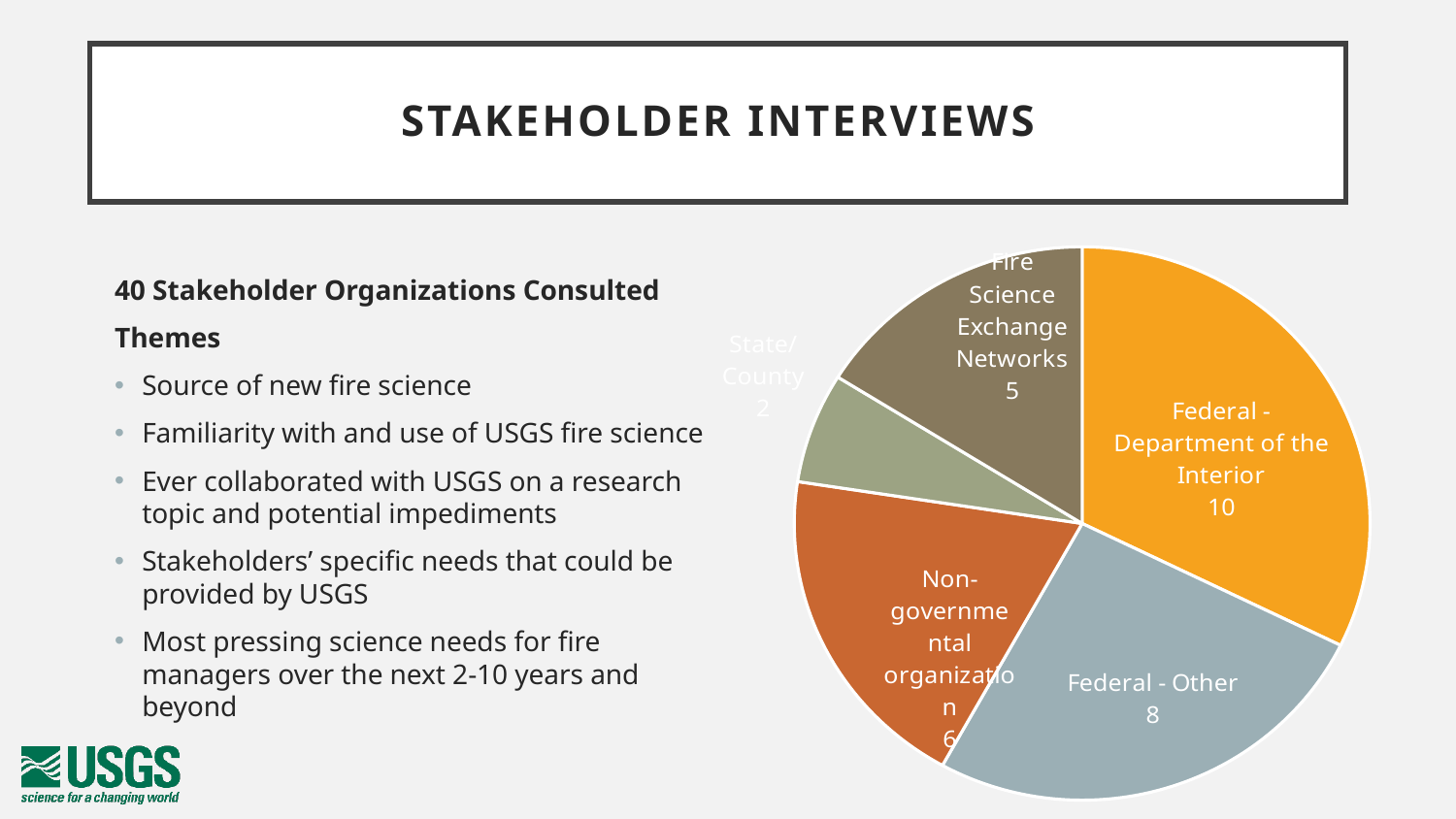
What kind of chart is shown on the slide? pie chart What is the value for Federal - Department of the Interior in the pie chart? 10 Which category has the largest slice in the pie chart? Federal - Department of the Interior What is the value for Fire Science Exchange Networks in the pie chart? 5 How many slices does the pie chart have? 5 What is the value for State/County in the pie chart? 2 Which is larger, Federal - Other or Fire Science Exchange Networks? Federal - Other What is the value for Non-governmental organization in the pie chart? 6 Which category has the smallest slice in the pie chart? State/County What is the difference between the values for Federal - Other and Non-governmental organization? 2 What is the value for Federal - Other in the pie chart? 8 What is the difference between the values for Federal - Department of the Interior and Federal - Other? 2